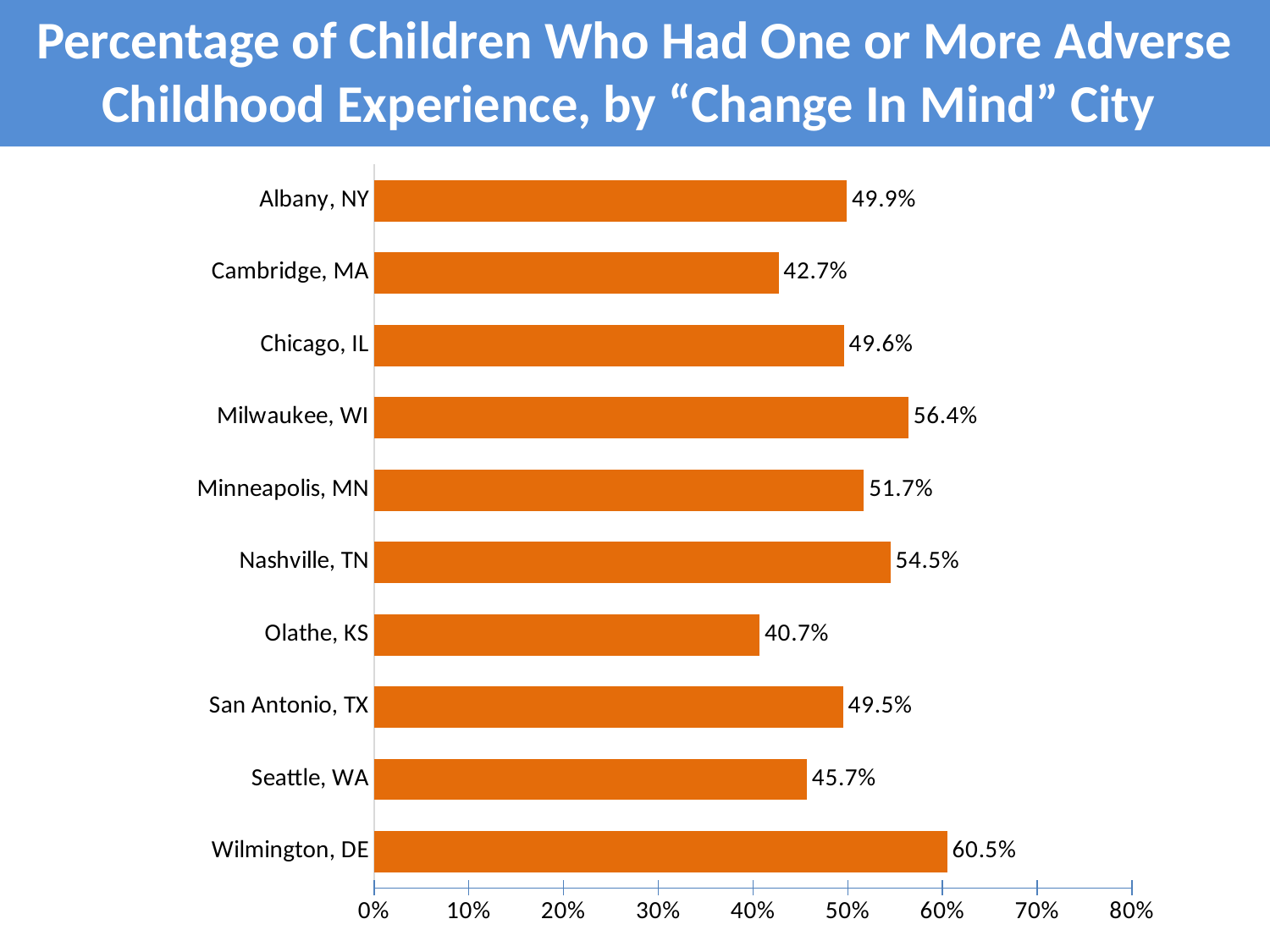
What kind of chart is shown on the slide? Bar chart Is the value for Nashville, TN greater or less than 50%? greater What is the difference between the values for Milwaukee, WI and Nashville, TN? 1.9% What is the maximum value shown on the horizontal axis? 80% How many cities are shown in the chart? 10 What is the difference between the values for Wilmington, DE and Olathe, KS? 19.8% What is the value for Milwaukee, WI? 56.4% Which city has the highest percentage? Wilmington, DE Which is larger, the value for Cambridge, MA or the value for Minneapolis, MN? Minneapolis, MN Which city has the lowest percentage? Olathe, KS What is the value for Olathe, KS? 40.7% What is the value for Seattle, WA? 45.7%